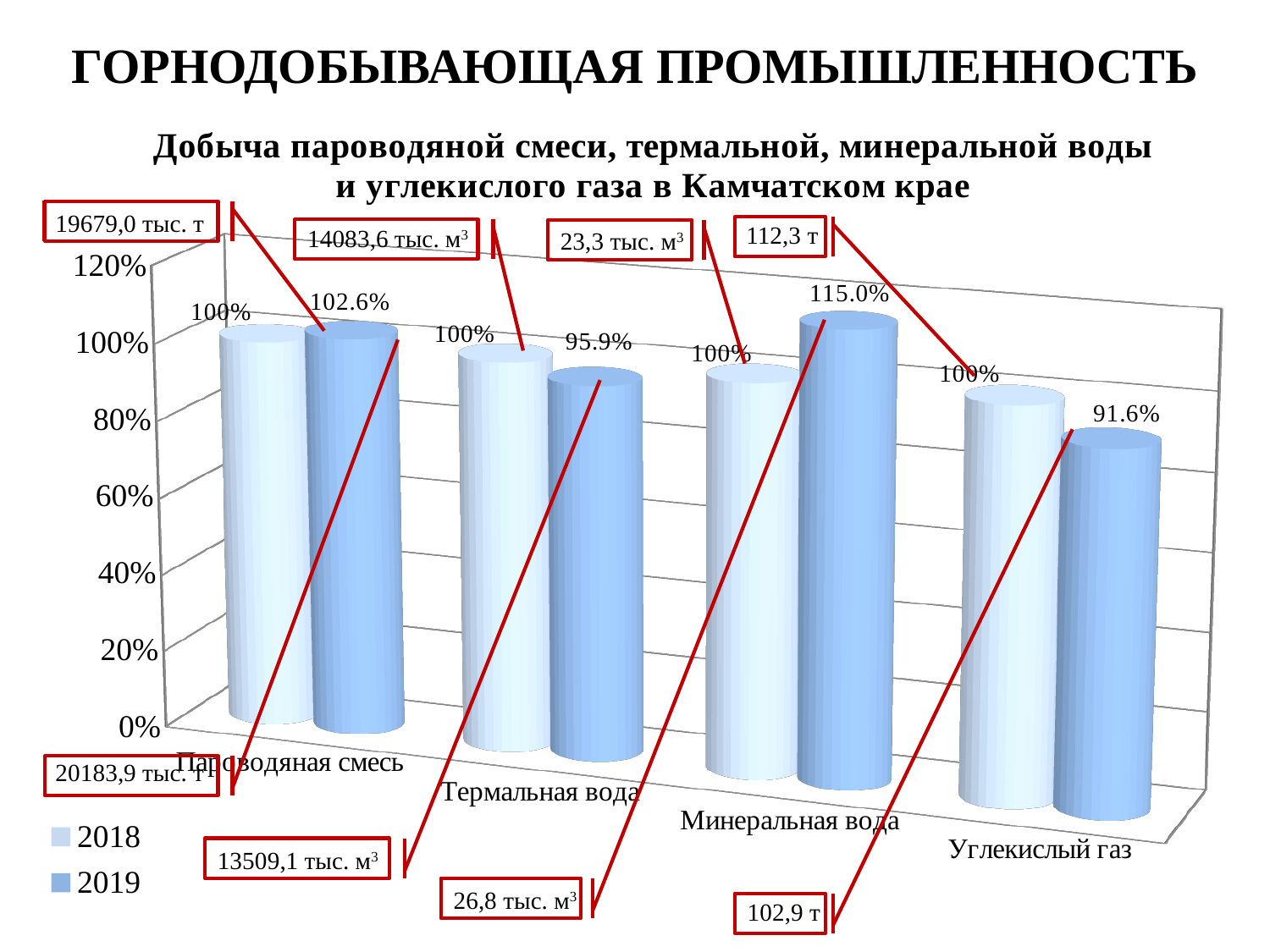
What is the difference between the 2019 values for Минеральная вода and Углекислый газ? 23.4% What is the 2019 value for Углекислый газ? 91.6% Which is larger, the 2019 value for Пароводяная смесь or the 2019 value for Термальная вода? Пароводяная смесь Which category has the lowest 2019 value? Углекислый газ What is the 2019 value for Пароводяная смесь? 102.6% What is the 2019 value for Термальная вода? 95.9% What type of chart is shown on the slide? bar chart Which series is shown in the darker blue colour in the legend? 2019 How many categories are shown on the x axis? 4 How many series does the legend list? 2 What is the 2019 value for Минеральная вода? 115.0% Which category has the highest 2019 value? Минеральная вода